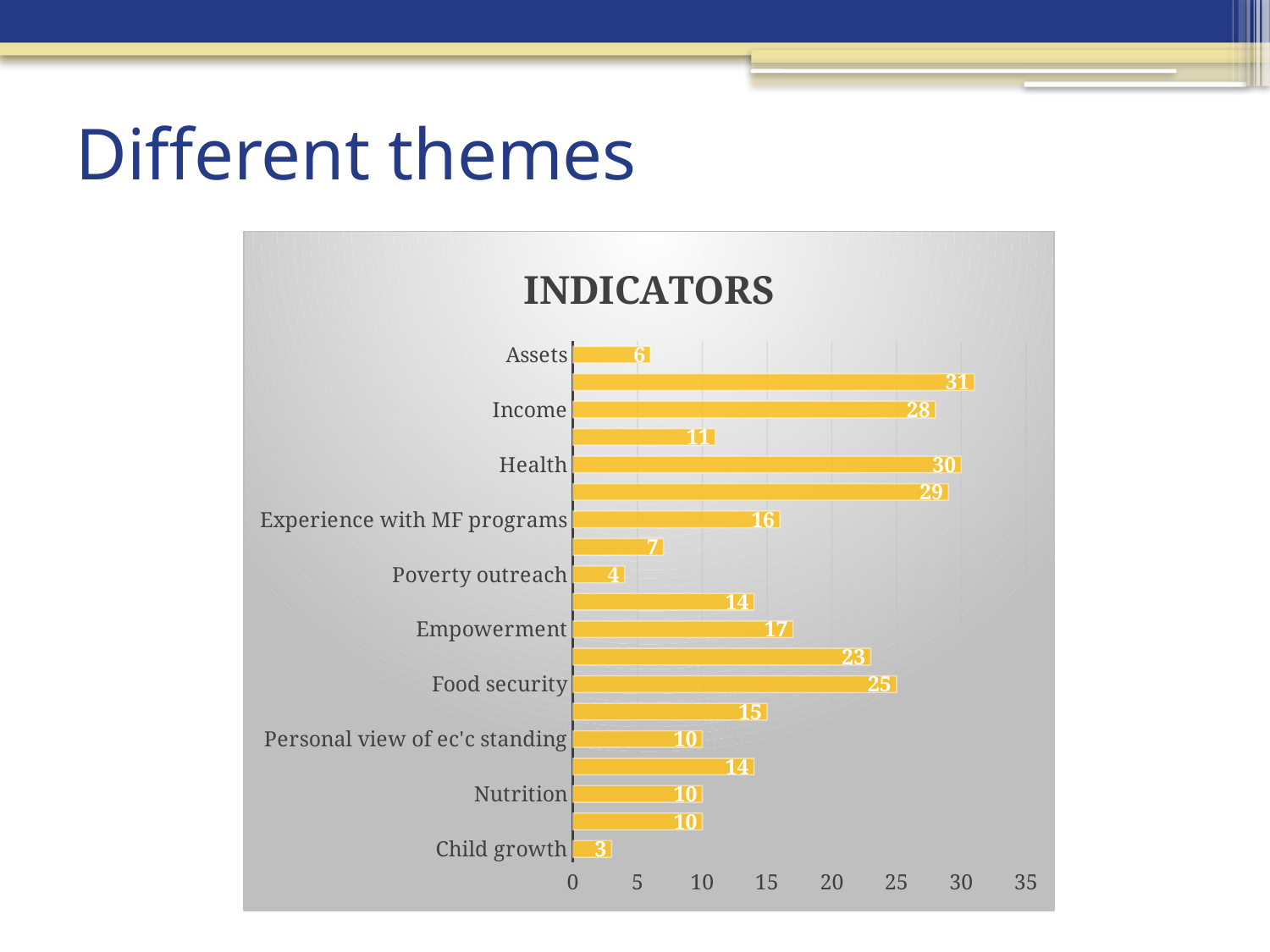
What is the value for Health? 30 Is the value for Income greater or less than 25? greater What is the value for Poverty outreach? 4 How many bars are plotted in the chart? 19 What is the difference between the values for Health and Assets? 24 Which is larger, the value for Empowerment or the value for Food security? Food security What is the value for Experience with MF programs? 16 What is the value for Food security? 25 What kind of chart is shown on the slide? bar chart What is the title of the chart? INDICATORS Which category has the lowest value? Child growth What is the value for Income? 28